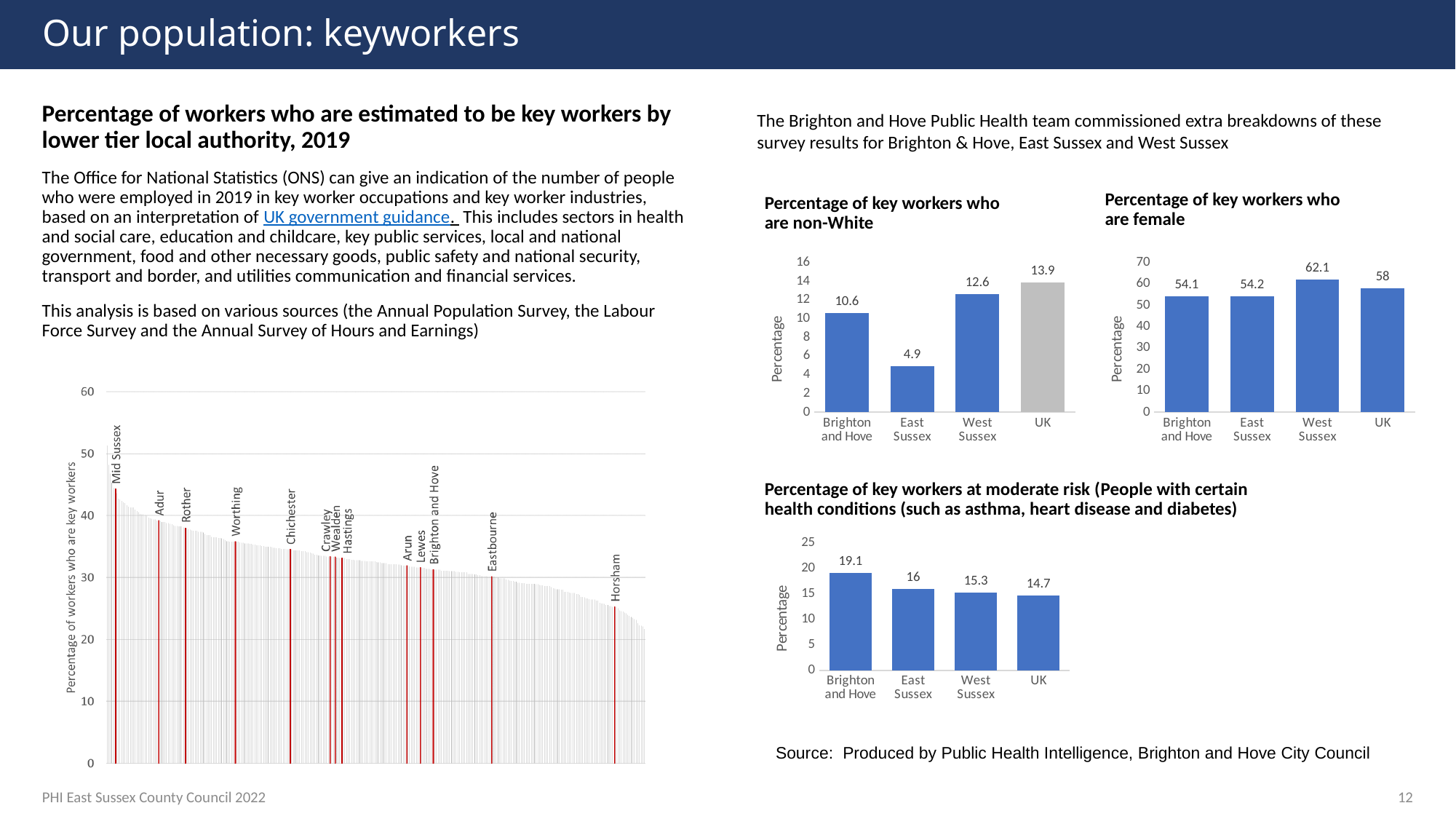
In the chart 'Percentage of key workers who are non-White', what is the value for East Sussex? 4.9 In the chart 'Percentage of key workers who are non-White', which category has the highest value? UK In the chart 'Percentage of key workers at moderate risk', which is larger, East Sussex or the UK? East Sussex In the large chart on the left showing the percentage of workers who are key workers by lower tier local authority, is the value for Horsham greater or less than 30? less In the chart 'Percentage of key workers who are female', what is the value for West Sussex? 62.1 In the chart 'Percentage of key workers who are non-White', what is the difference between West Sussex and Brighton and Hove? 2 In the large chart on the left showing the percentage of workers who are key workers by lower tier local authority, is the value for Mid Sussex greater or less than 40? greater In the chart 'Percentage of key workers who are female', what is the difference between the UK and East Sussex? 3.8 In the chart 'Percentage of key workers at moderate risk', what is the value for Brighton and Hove? 19.1 How many categories are shown in the chart 'Percentage of key workers at moderate risk'? 4 In the chart 'Percentage of key workers who are female', which category has the lowest value? Brighton and Hove In the large chart on the left showing the percentage of workers who are key workers by lower tier local authority, do the values rise or fall from left to right along the x axis? fall